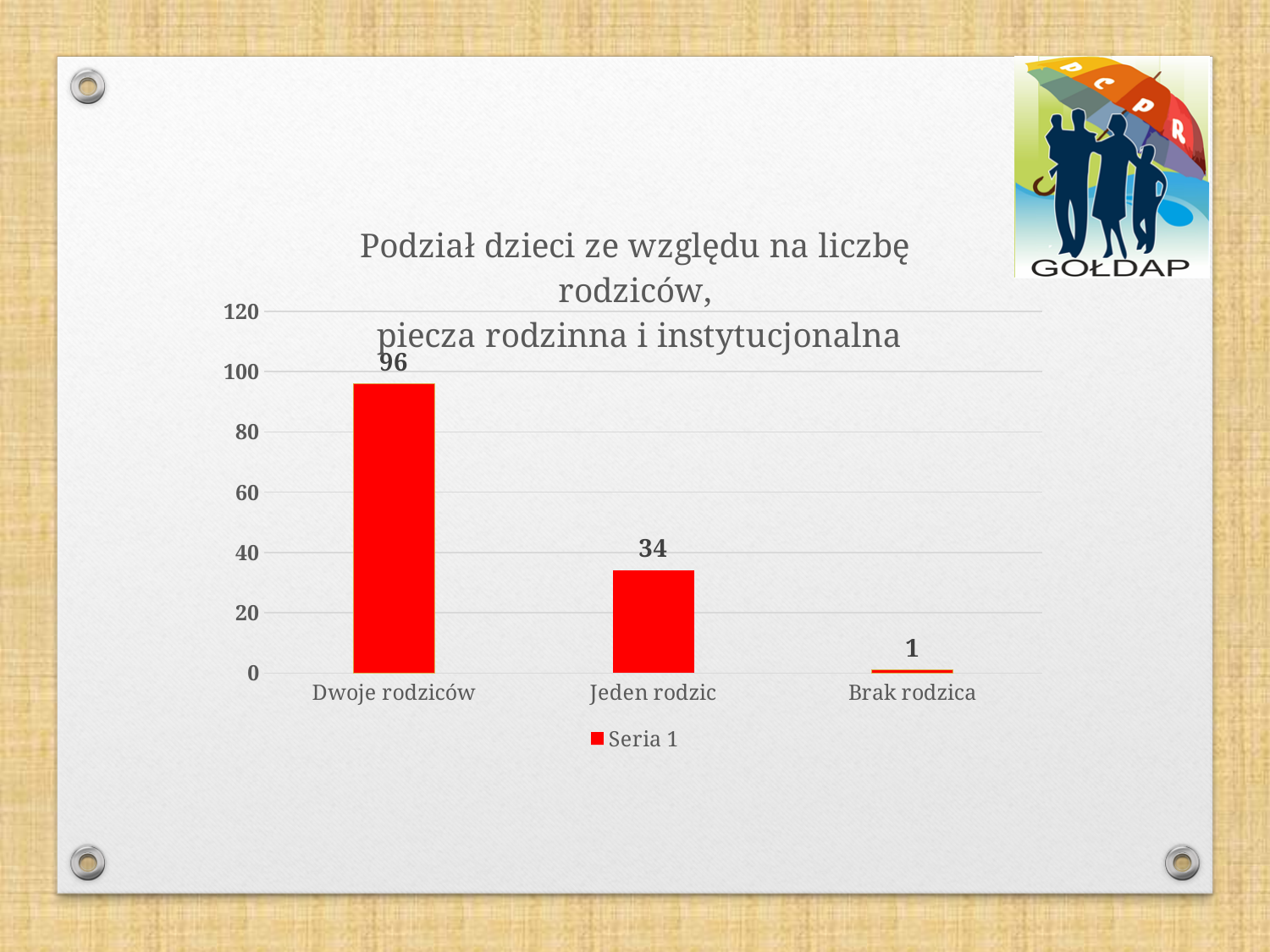
How many series does the legend list? 1 What is the value for Jeden rodzic? 34 What is the difference between the values for Jeden rodzic and Brak rodzica? 33 Which is larger, the value for Jeden rodzic or the value for Brak rodzica? Jeden rodzic What is the value for Dwoje rodziców? 96 What is the difference between the values for Dwoje rodziców and Jeden rodzic? 62 What kind of chart is shown on the slide? bar chart What is the value for Brak rodzica? 1 What is the name of the series shown in the legend? Seria 1 Which category has the highest value? Dwoje rodziców How many categories are shown on the x axis? 3 Which category has the lowest value? Brak rodzica